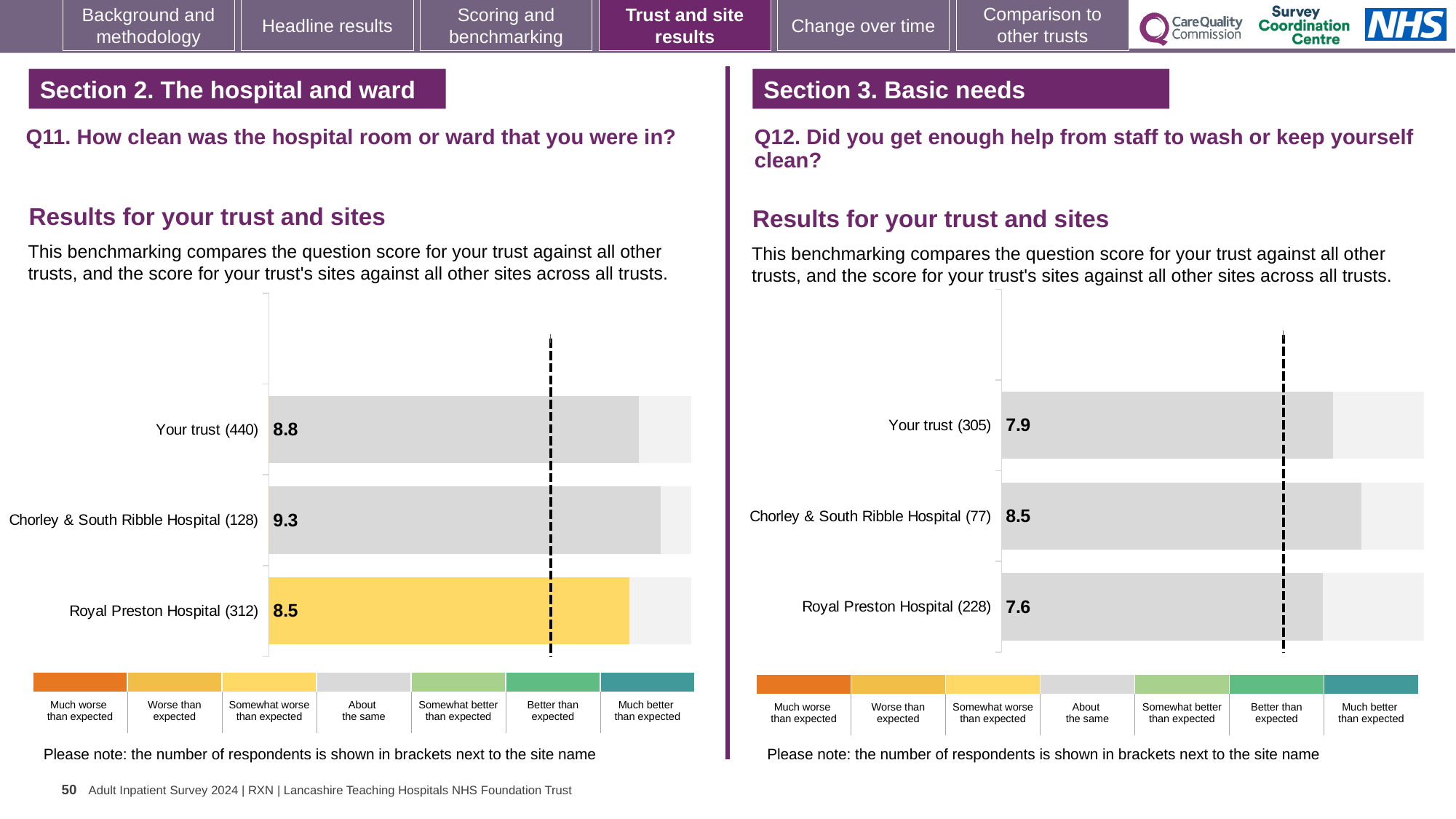
On the Q12 chart (right), what is the score for Chorley & South Ribble Hospital? 8.5 On the Q11 chart (left), what is the score for Chorley & South Ribble Hospital? 9.3 What type of chart is used for the Q11 results (left)? Bar chart On the Q11 chart (left), what is the score for Royal Preston Hospital? 8.5 On the Q11 chart (left), how many respondents are shown in brackets for Royal Preston Hospital? 312 On the Q12 chart (right), what is the difference between the scores for Your trust and Royal Preston Hospital? 0.3 How many bars are plotted on the Q12 chart (right)? 3 On the Q12 chart (right), which site or trust has the lowest score? Royal Preston Hospital On the Q12 chart (right), what is the score for Your trust? 7.9 On the Q11 chart (left), what is the score for Your trust? 8.8 On the Q11 chart (left), which site or trust has the highest score? Chorley & South Ribble Hospital On the Q11 chart (left), what is the difference between the scores for Chorley & South Ribble Hospital and Royal Preston Hospital? 0.8